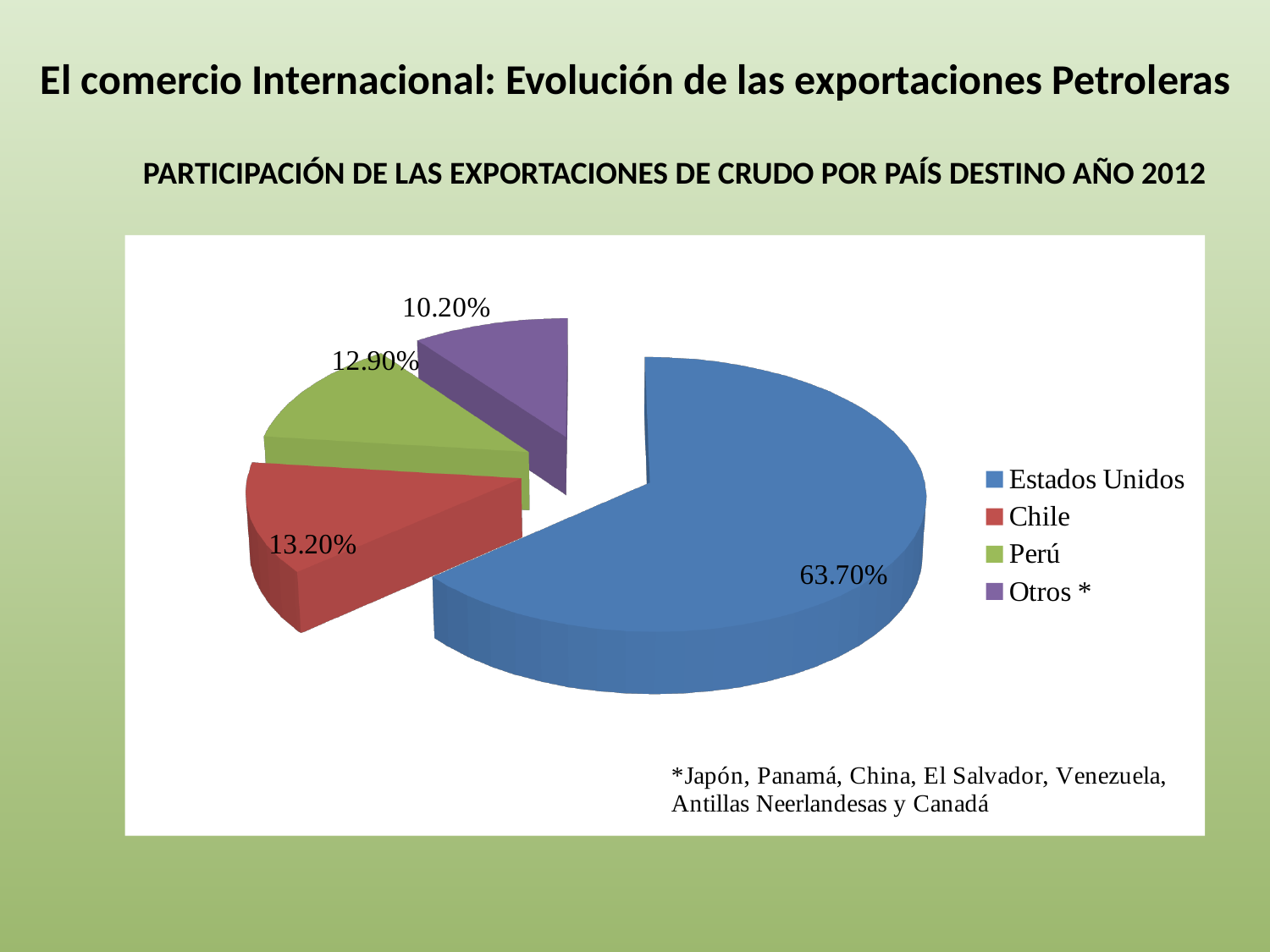
Which destination has the largest share of crude exports? Estados Unidos What share of crude exports went to Estados Unidos in 2012? 63.70% What share of crude exports went to Chile? 13.20% What share of crude exports went to Otros *? 10.20% Which colour represents Chile in the pie chart? Red What is the difference in share between Estados Unidos and Chile? 50.50% What is the difference in share between Chile and Perú? 0.30% How many slices does the pie chart have? 4 What kind of chart is shown on the slide? Pie chart Which has a larger share, Perú or Otros *? Perú Which destination has the smallest share of crude exports? Otros * What share of crude exports went to Perú? 12.90%